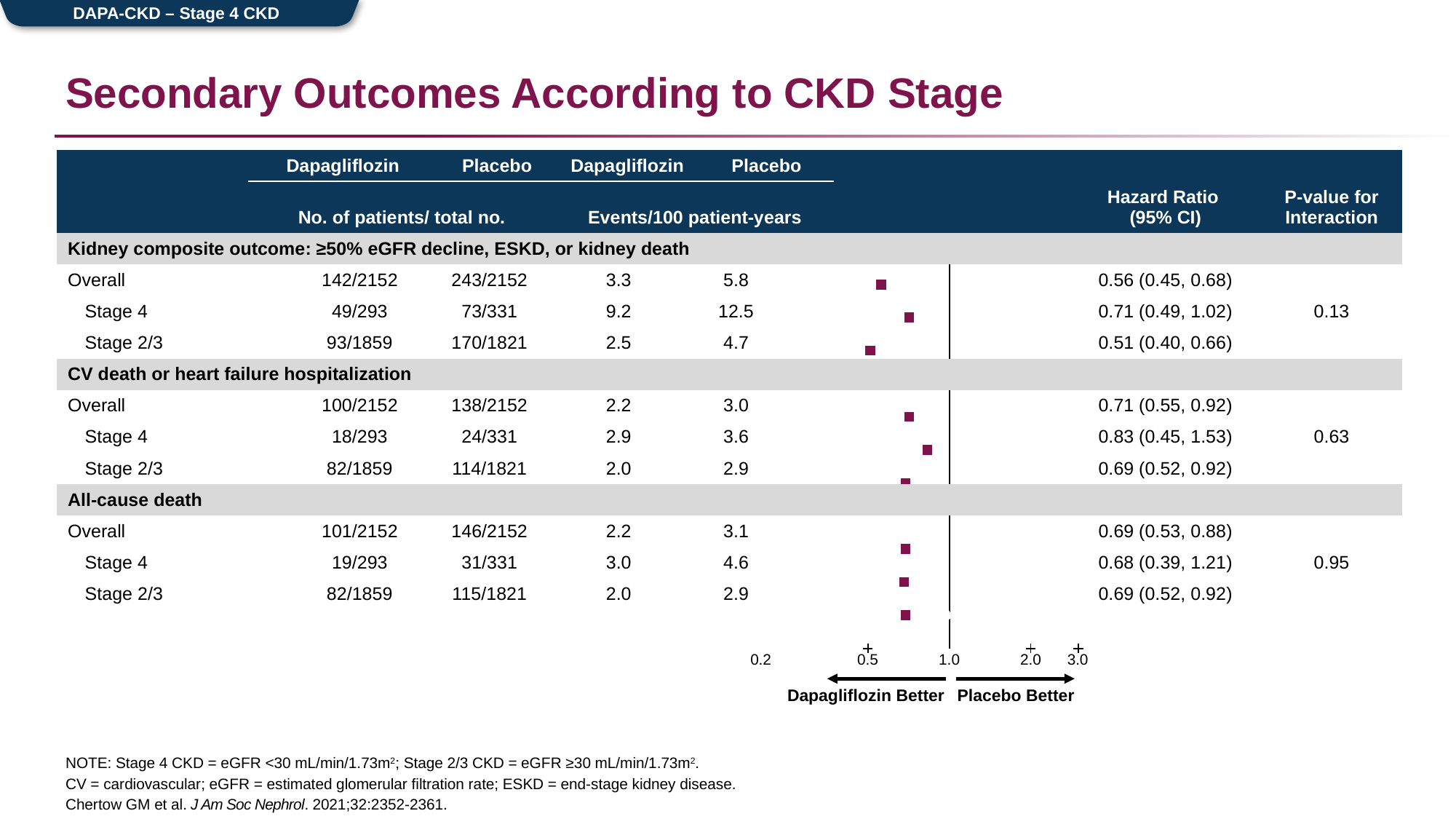
What is the hazard ratio (95% CI) for the Overall group for all-cause death? 0.69 (0.53, 0.88) What is the hazard ratio (95% CI) for Stage 4 patients for the kidney composite outcome? 0.71 (0.49, 1.02) What label appears on the left side of the forest plot's x axis, below the arrow? Dapagliflozin Better Which row in the forest plot has the highest hazard ratio? Stage 4, CV death or heart failure hospitalization (0.83) What kind of chart is shown on the slide? Forest plot How many hazard ratio points are plotted in the forest plot? 9 What is the placebo event rate per 100 patient-years for Stage 4 patients for the kidney composite outcome? 12.5 Which row in the forest plot has the lowest hazard ratio? Stage 2/3, kidney composite outcome (0.51) Which has the larger hazard ratio for the kidney composite outcome: Stage 4 or Stage 2/3? Stage 4 What is the P-value for interaction for CV death or heart failure hospitalization? 0.63 Is the hazard ratio for Stage 4 patients for all-cause death greater or less than 1.0? less What is the difference between the hazard ratio for Stage 4 and the Overall hazard ratio for the kidney composite outcome? 0.15